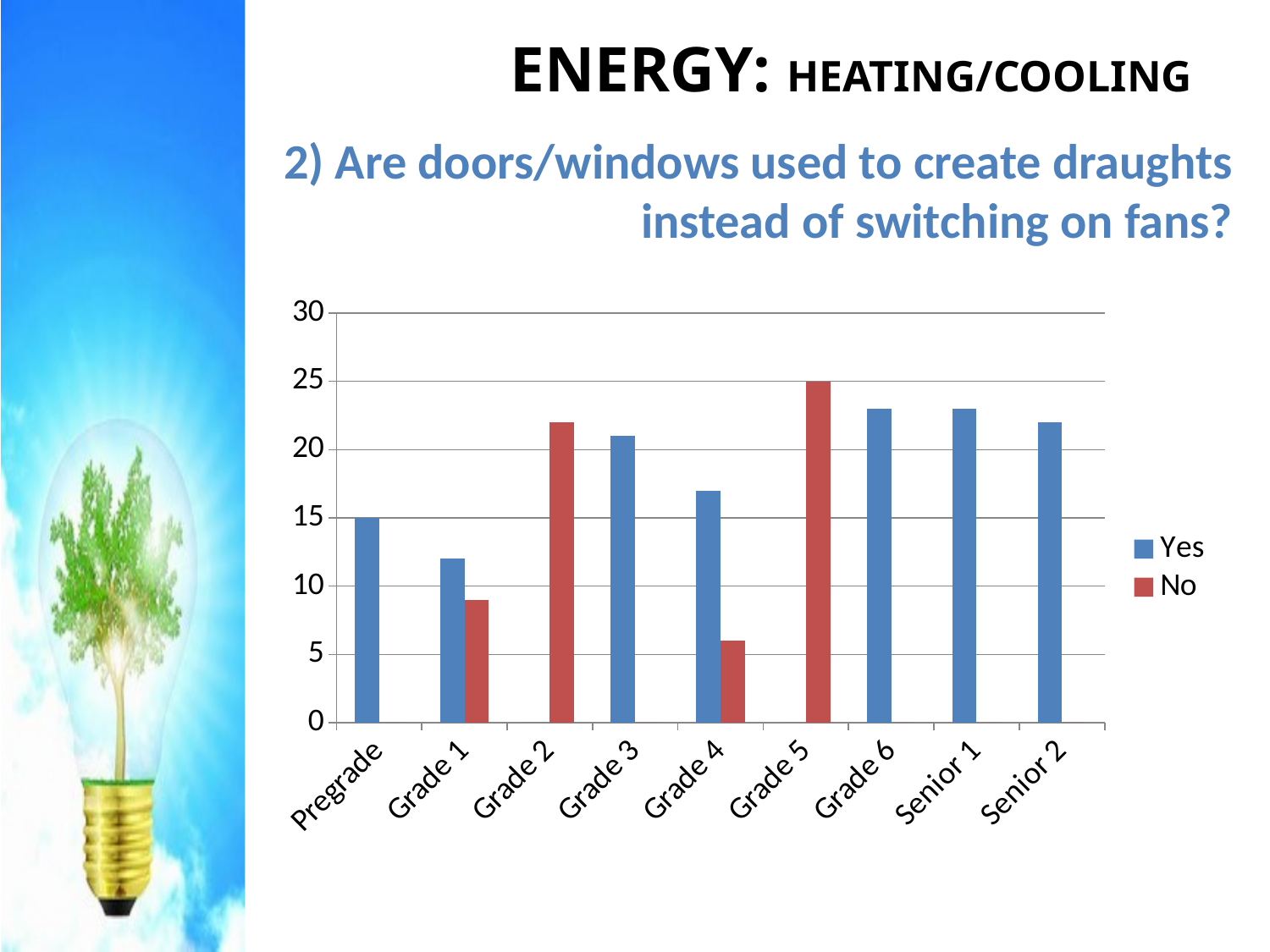
How many grade categories are shown on the x axis? 9 Which category has the shortest bar in the chart? Grade 4 Which category has the tallest bar in the chart? Grade 5 What kind of chart is shown on the slide? bar chart What is the Yes value for Pregrade? 15 Is the Yes value for Grade 6 greater or less than 20? greater Which is larger, the No value for Grade 2 or the Yes value for Grade 1? No value for Grade 2 Is the No value for Grade 4 greater or less than 10? less How many series does the legend list? 2 Is the Yes value for Grade 1 greater or less than 15? less What colour are the No bars in the chart? red What is the No value for Grade 5? 25